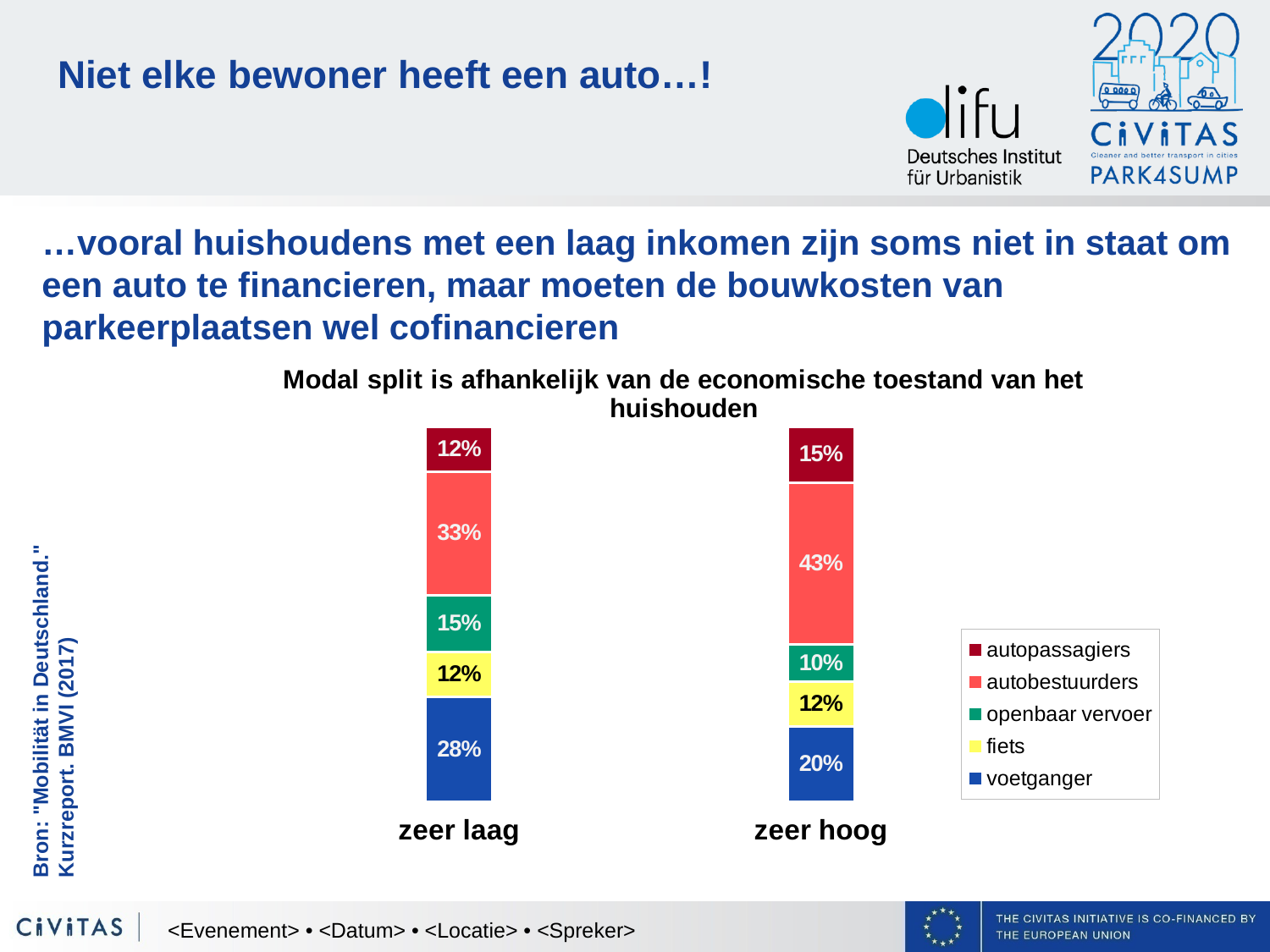
What is the value for voetganger in the zeer laag category? 28% How many categories are shown on the x axis? 2 What is the title of the chart? Modal split is afhankelijk van de economische toestand van het huishouden What is the value for openbaar vervoer in the zeer hoog category? 10% What kind of chart is shown on the slide? stacked bar chart How many series does the legend list? 5 Which category has the larger value for voetganger, zeer laag or zeer hoog? zeer laag What is the value for autopassagiers in the zeer laag category? 12% Which series has the largest share in the zeer laag bar? autobestuurders What is the value for autobestuurders in the zeer hoog category? 43% Which series has the smallest share in the zeer hoog bar? openbaar vervoer What is the difference between the autobestuurders values for zeer hoog and zeer laag? 10%